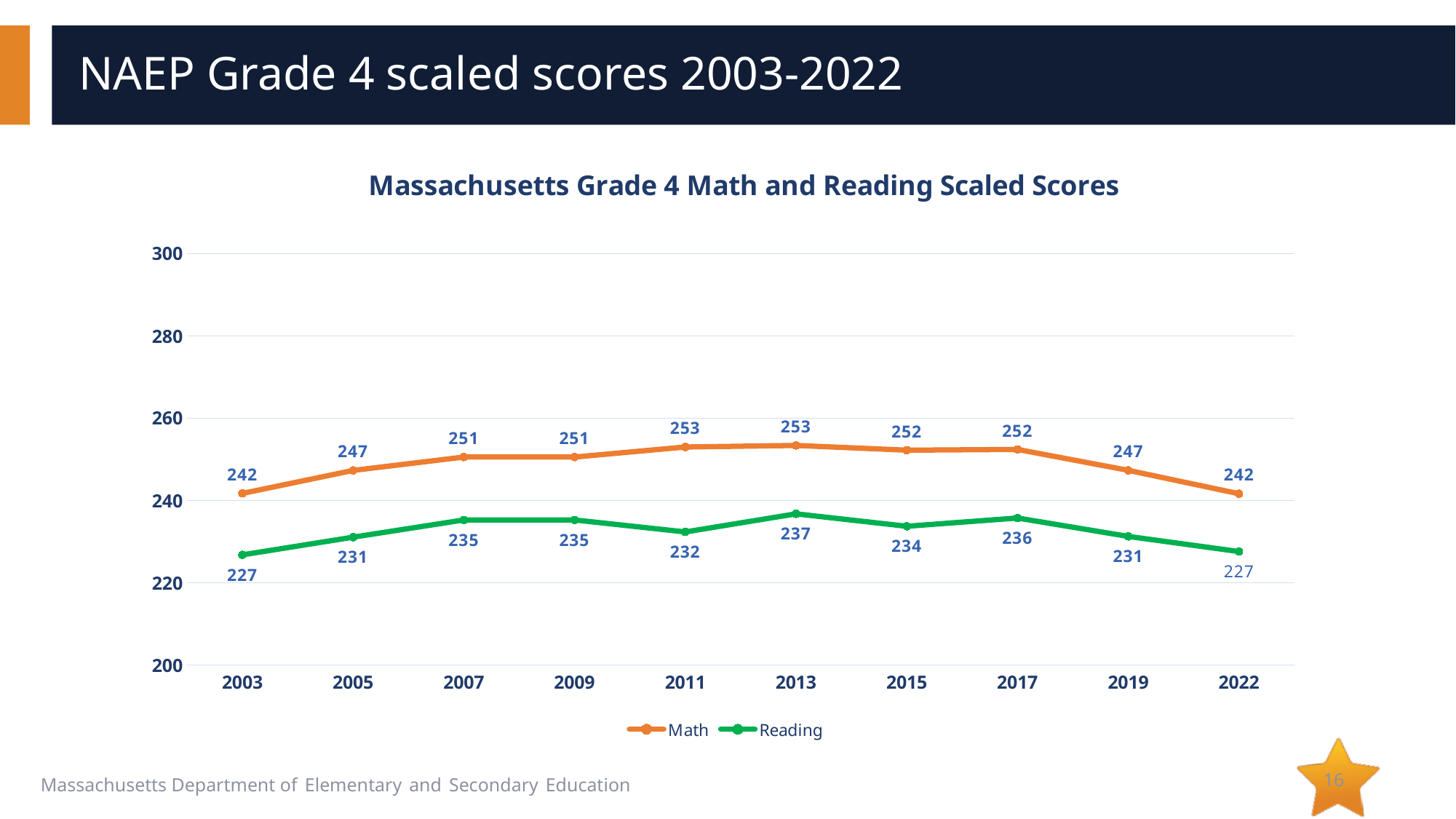
How many series does the legend list? 2 Which colour is used for the Reading series? green What was the Reading scaled score in 2011? 232 In which year was the Reading scaled score highest? 2013 What is the difference between the Math and Reading scaled scores in 2003? 15 Is the Math scaled score in 2011 greater or less than 260? less What was the Reading scaled score in 2022? 227 How many years are shown on the x axis? 10 What is the difference between the Math scaled score in 2013 and in 2022? 11 What was the Math scaled score in 2013? 253 Which was higher in 2019, the Math score or the Reading score? Math What kind of chart is shown on the slide? line chart